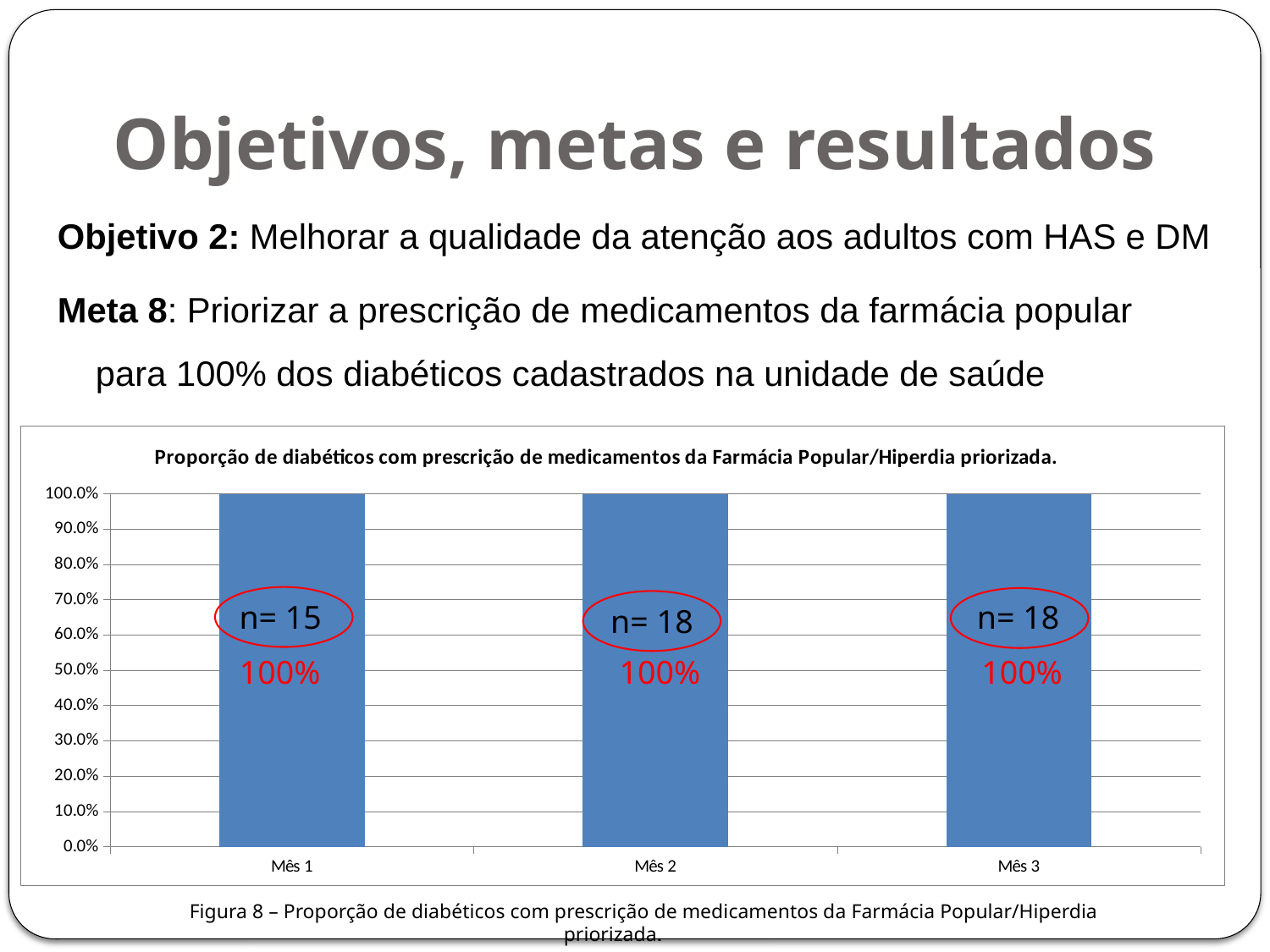
Do the values rise, fall, or stay the same from Mês 1 to Mês 3? stay the same What is the n value annotated on the bar for Mês 1? n= 15 What is the value shown for Mês 2? 100% What is the value shown for Mês 3? 100% What is the value shown for Mês 1? 100% What is the highest value shown on the y axis of the chart? 100.0% What is the n value annotated on the bar for Mês 3? n= 18 Is the value for Mês 2 greater or less than 50.0%? greater What is the difference between the values for Mês 1 and Mês 3? 0% What type of chart is shown on the slide? bar chart How many categories (months) are shown on the x axis of the chart? 3 What is the title of the chart? Proporção de diabéticos com prescrição de medicamentos da Farmácia Popular/Hiperdia priorizada.